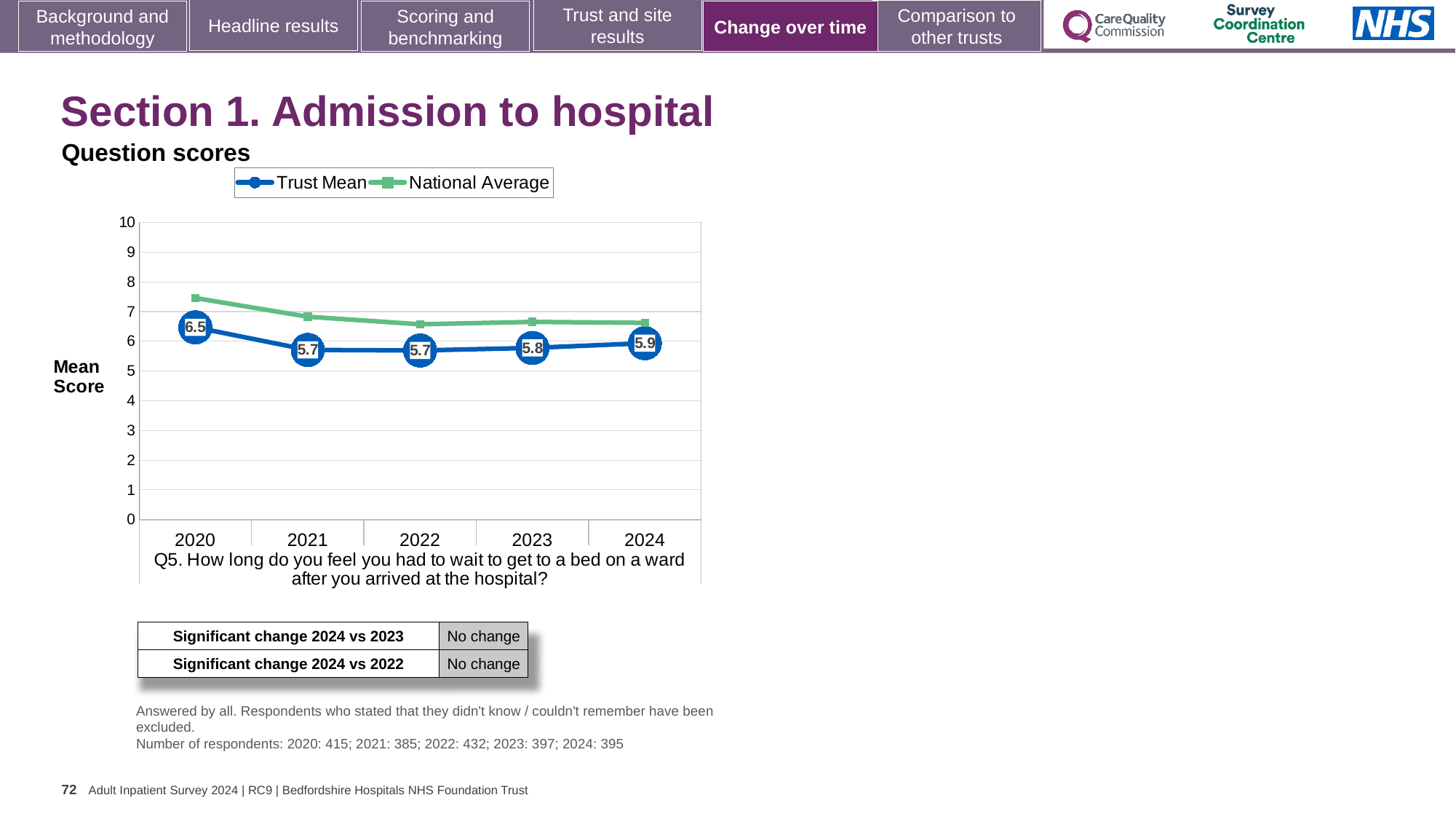
Is the National Average value for 2020 greater or less than 7? greater What kind of chart is shown on the slide? line chart What is the Trust Mean score for 2024? 5.9 Is the National Average value for 2022 greater or less than 7? less How many series does the legend list? 2 What is the Trust Mean score for 2023? 5.8 Which is larger, the Trust Mean score in 2021 or in 2024? 2024 In which year is the Trust Mean score highest? 2020 How many years are shown on the x axis of the chart? 5 What is the difference between the Trust Mean score in 2020 and in 2024? 0.6 Does the Trust Mean score rise or fall from 2021 to 2024? rise What is the Trust Mean score for 2020? 6.5